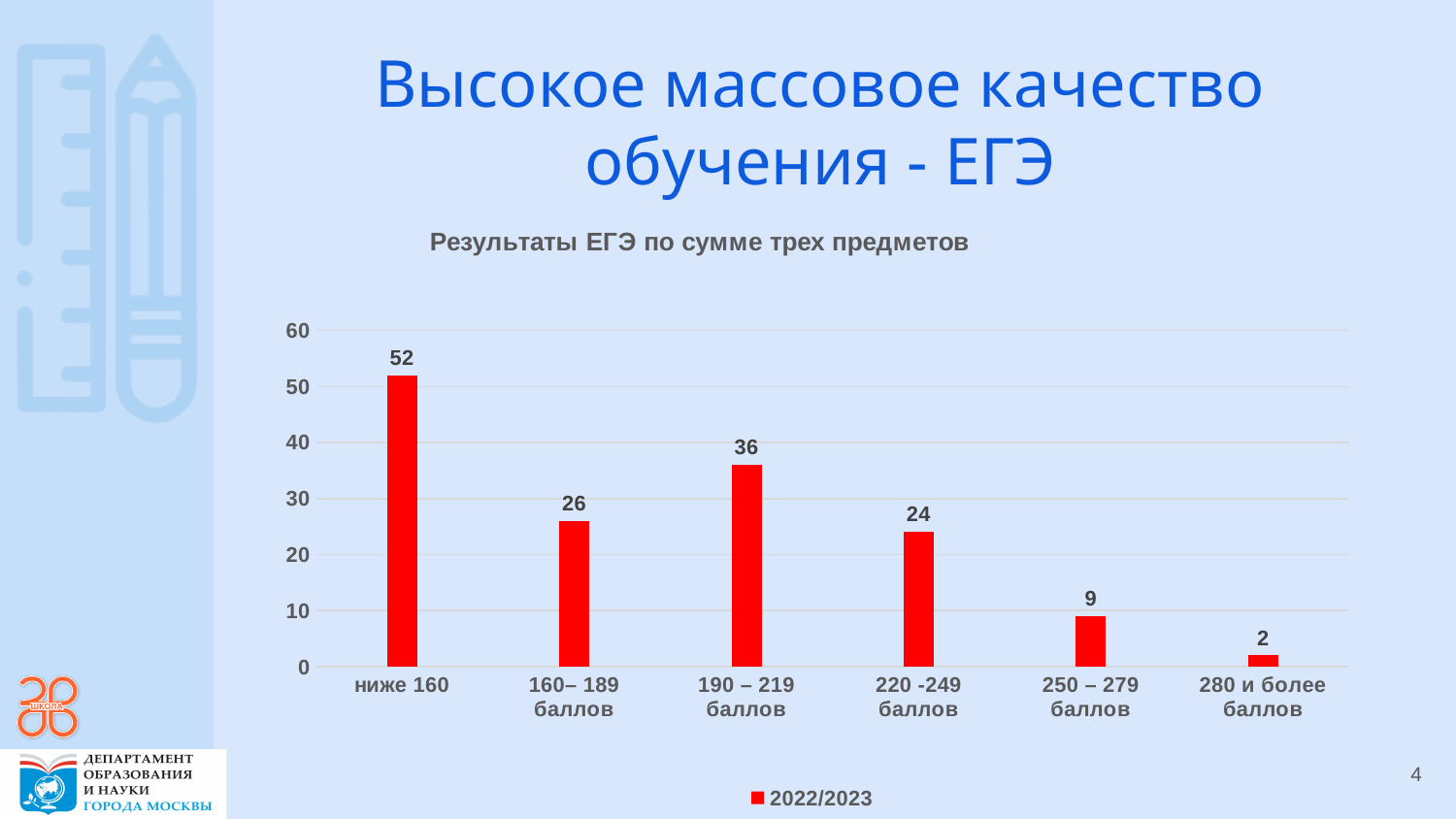
What is the value for the category "190 – 219 баллов"? 36 What is the title of the chart? Результаты ЕГЭ по сумме трех предметов Which category has the highest value? ниже 160 Which category has the lowest value? 280 и более баллов What kind of chart is shown on the slide? bar chart How many categories are shown on the x axis? 6 Which is larger, the value for "190 – 219 баллов" or the value for "220 -249 баллов"? 190 – 219 баллов What is the value for the category "ниже 160"? 52 What is the value for the category "250 – 279 баллов"? 9 Is the value for "160– 189 баллов" greater or less than 30? less What is the difference between the values for "ниже 160" and "160– 189 баллов"? 26 How many series does the legend list? 1